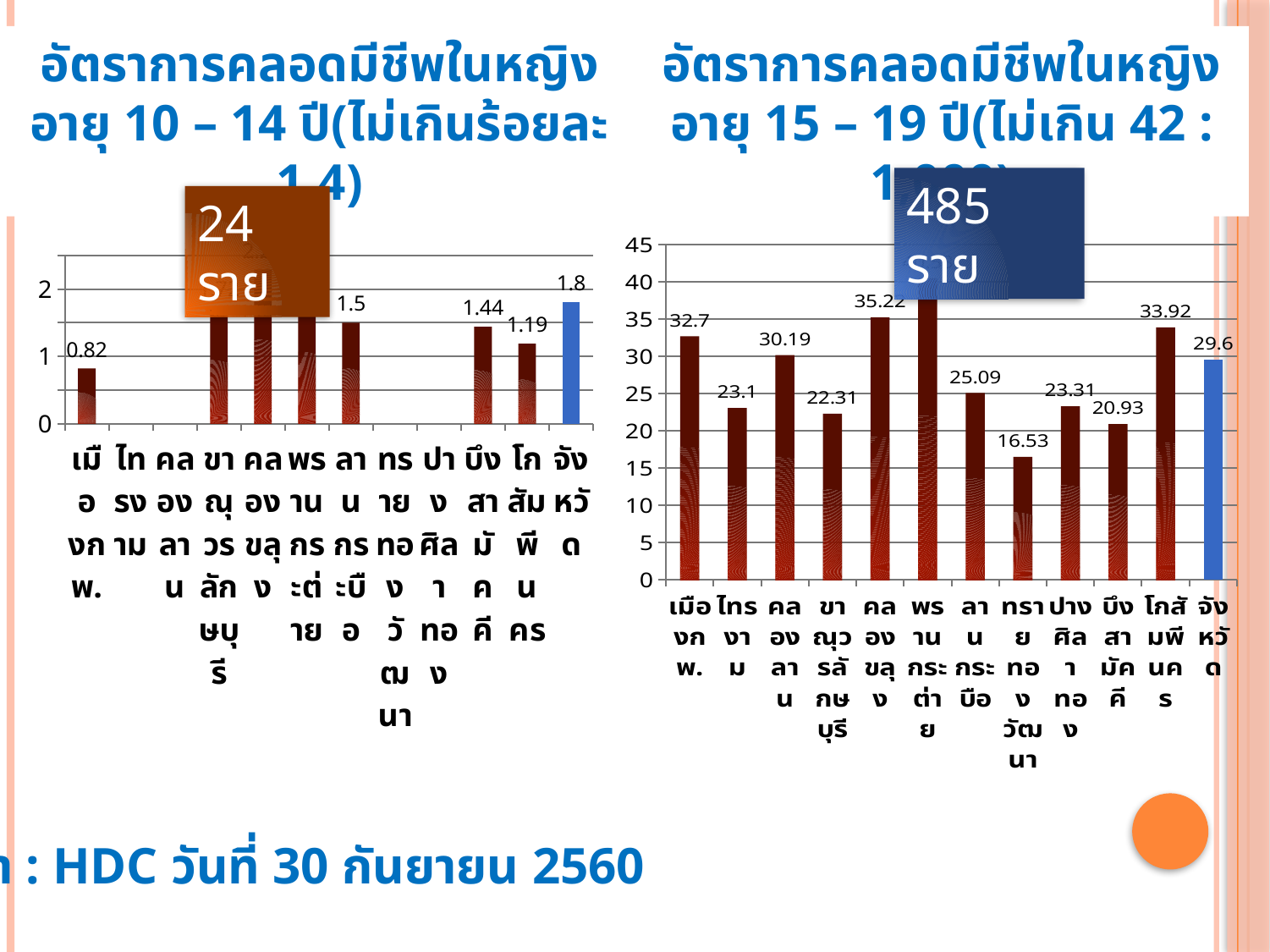
In the right chart (อายุ 15 – 19 ปี), how many categories are shown on the x axis? 12 In the right chart (อายุ 15 – 19 ปี), which is larger, the value for คลองลาน or the value for ลานกระบือ? คลองลาน In the left chart (อายุ 10 – 14 ปี), what is the value for บึงสามัคคี? 1.44 In the right chart (อายุ 15 – 19 ปี), what is the value for เมืองกพ.? 32.7 What kind of chart is the left chart (อายุ 10 – 14 ปี)? bar chart In the left chart (อายุ 10 – 14 ปี), what is the value for จังหวัด? 1.8 In the right chart (อายุ 15 – 19 ปี), what is the difference between the values for คลองขลุง and ไทรงาม? 12.12 In the right chart (อายุ 15 – 19 ปี), what is the value for จังหวัด? 29.6 In the left chart (อายุ 10 – 14 ปี), what is the value for เมืองกพ.? 0.82 In the right chart (อายุ 15 – 19 ปี), which category has the lowest value? ทรายทองวัฒนา In the right chart (อายุ 15 – 19 ปี), what is the value for ทรายทองวัฒนา? 16.53 In the left chart (อายุ 10 – 14 ปี), is the value for ลานกระบือ greater or less than 1? greater